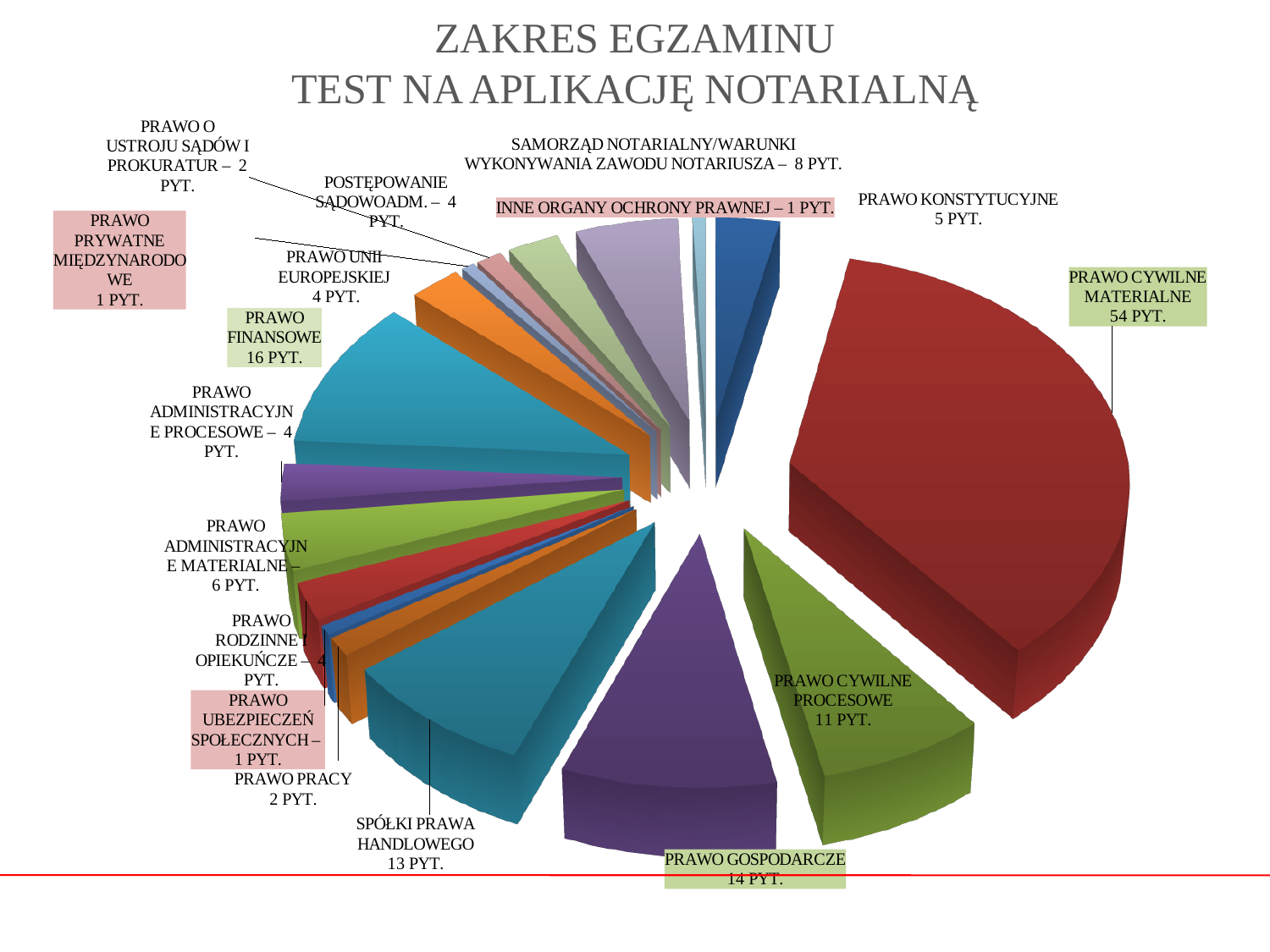
What is the difference in the number of questions between PRAWO CYWILNE MATERIALNE and PRAWO FINANSOWE? 38 What is the title of the slide containing the chart? ZAKRES EGZAMINU TEST NA APLIKACJĘ NOTARIALNĄ How many questions are allocated to SAMORZĄD NOTARIALNY/WARUNKI WYKONYWANIA ZAWODU NOTARIUSZA? 8 PYT. How many questions are allocated to PRAWO KONSTYTUCYJNE? 5 PYT. Which category has the largest slice of the pie? PRAWO CYWILNE MATERIALNE How many categories are shown in the pie chart? 17 How many questions are allocated to SPÓŁKI PRAWA HANDLOWEGO? 13 PYT. How many questions (PYT.) are allocated to PRAWO CYWILNE MATERIALNE? 54 PYT. What type of chart is shown on the slide? Pie chart Which has more questions: PRAWO CYWILNE PROCESOWE or PRAWO ADMINISTRACYJNE MATERIALNE? PRAWO CYWILNE PROCESOWE Which has more questions: PRAWO GOSPODARCZE or SPÓŁKI PRAWA HANDLOWEGO? PRAWO GOSPODARCZE How many questions are allocated to PRAWO FINANSOWE? 16 PYT.